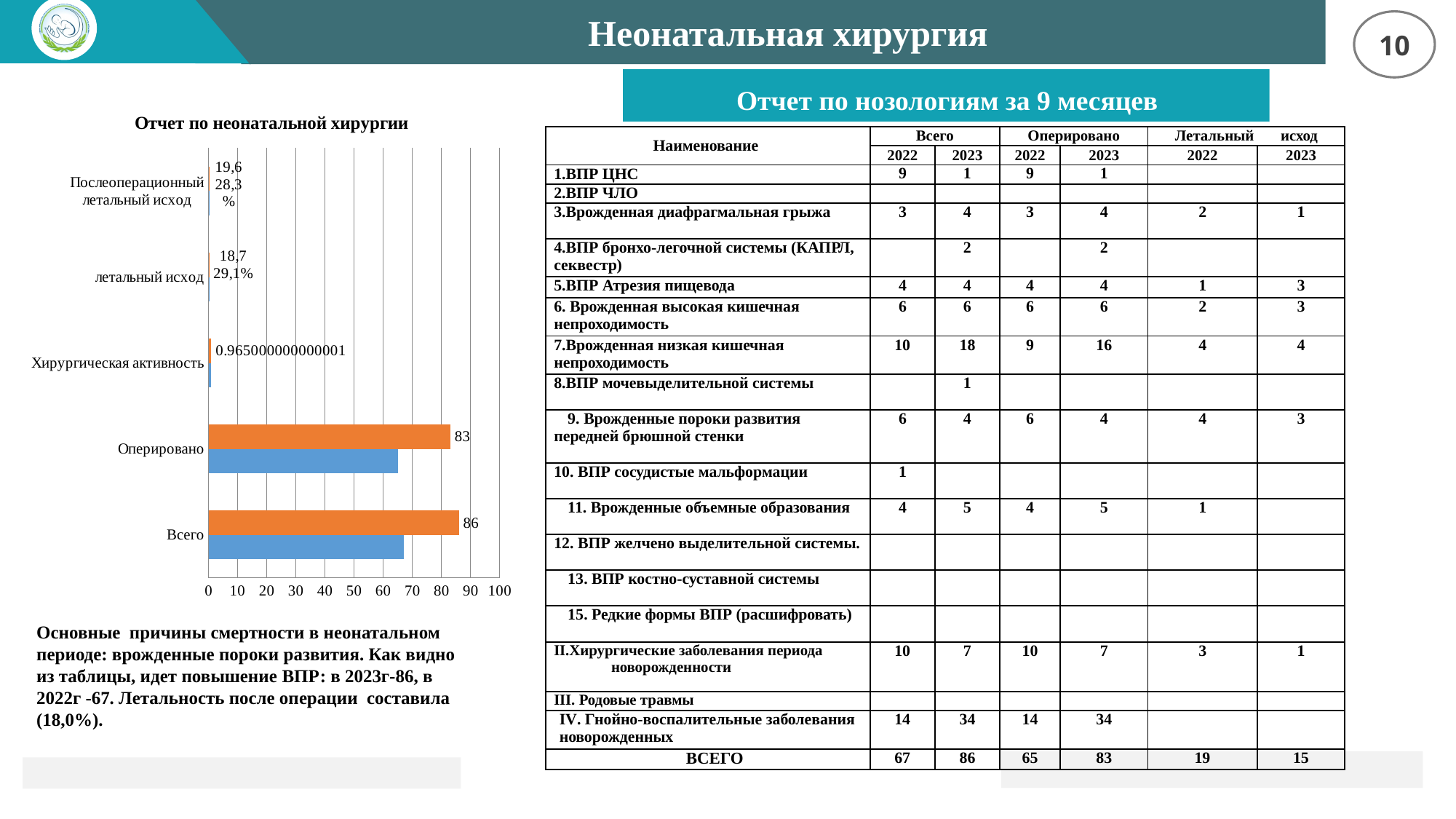
Which orange bar is longer: Всего or Оперировано? Всего What value is labelled on the orange bar for Оперировано? 83 What is the maximum value shown on the horizontal axis of the chart? 100 How many categories are shown on the vertical axis of the chart? 5 What is the title of the chart on the left of the slide? Отчет по неонатальной хирургии Is the value of the blue bar for Оперировано greater or less than 70? less What kind of chart is shown on the slide? bar chart What is the difference between the labelled orange bars for Всего and Оперировано? 3 Is the value of the blue bar for Всего greater or less than 60? greater What value is labelled on the orange bar for Всего? 86 What data label is shown next to the bar for Хирургическая активность? 0.965000000000001 Which category has the longest bar in the chart? Всего